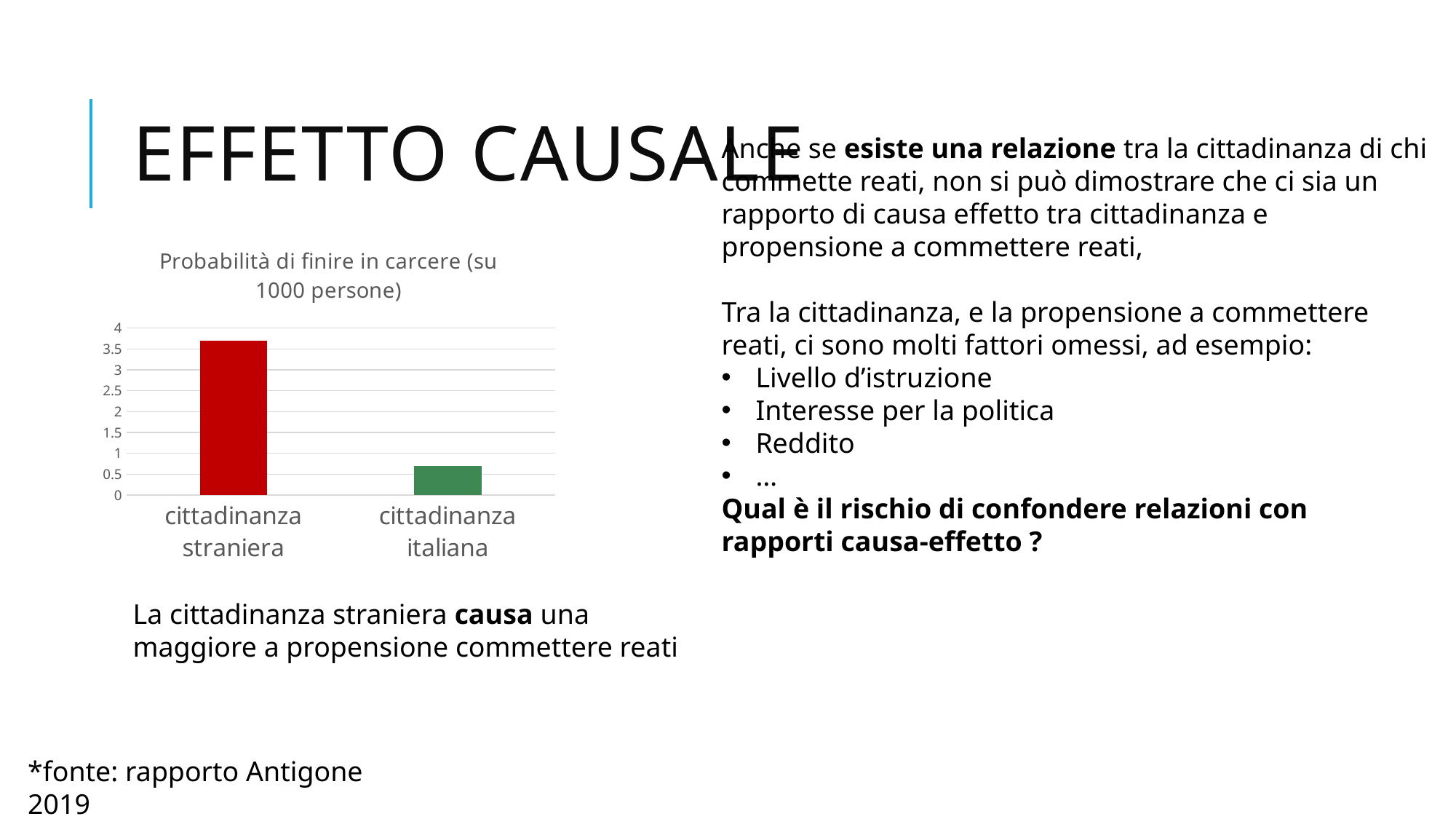
Is the value for cittadinanza straniera greater or less than 4? less Which category has the highest value in the chart? cittadinanza straniera Is the value for cittadinanza italiana greater or less than 1? less Is the value for cittadinanza italiana greater or less than 2? less Do the values rise or fall from left to right along the x axis? fall What is the title of the chart? Probabilità di finire in carcere (su 1000 persone) Which is larger, the value for cittadinanza straniera or the value for cittadinanza italiana? cittadinanza straniera What kind of chart is shown on the slide? bar chart How many categories are shown in the chart? 2 What colour is the bar for cittadinanza straniera? red Which category has the lowest value in the chart? cittadinanza italiana